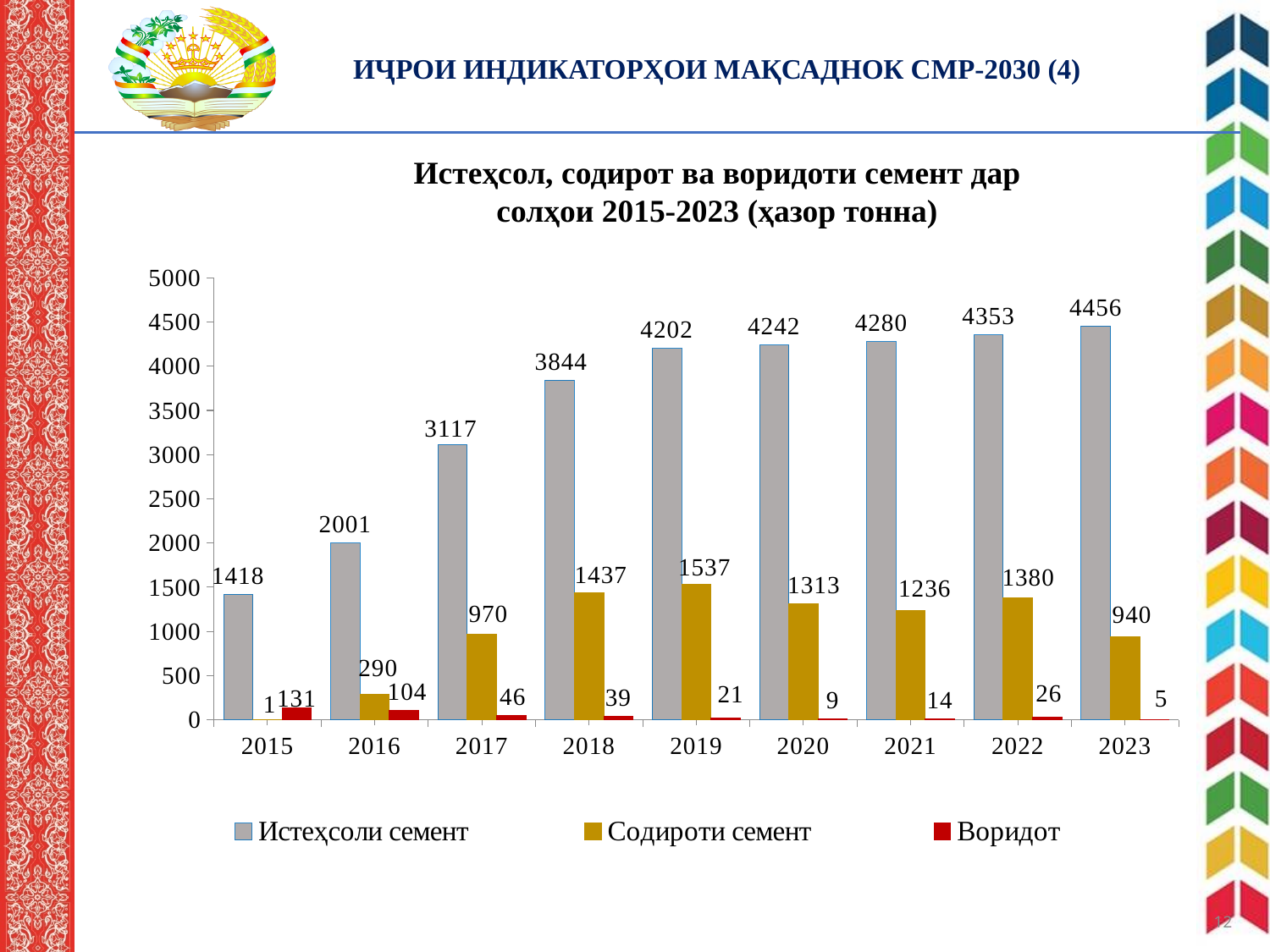
What is the difference between Истеҳсоли семент in 2023 and in 2015? 3038 How many years are shown on the x axis? 9 What is the value of Содироти семент for 2019? 1537 In which year is Содироти семент lowest? 2015 Which is larger: Содироти семент in 2018 or in 2023? 2018 Does Истеҳсоли семент rise or fall from 2015 to 2023? rise Is the value of Истеҳсоли семент for 2017 greater or less than 3000? greater How many series does the legend list? 3 What is the value of Истеҳсоли семент for 2023? 4456 What is the value of Воридот for 2015? 131 What kind of chart is shown on the slide? bar chart In which year is Истеҳсоли семент highest? 2023